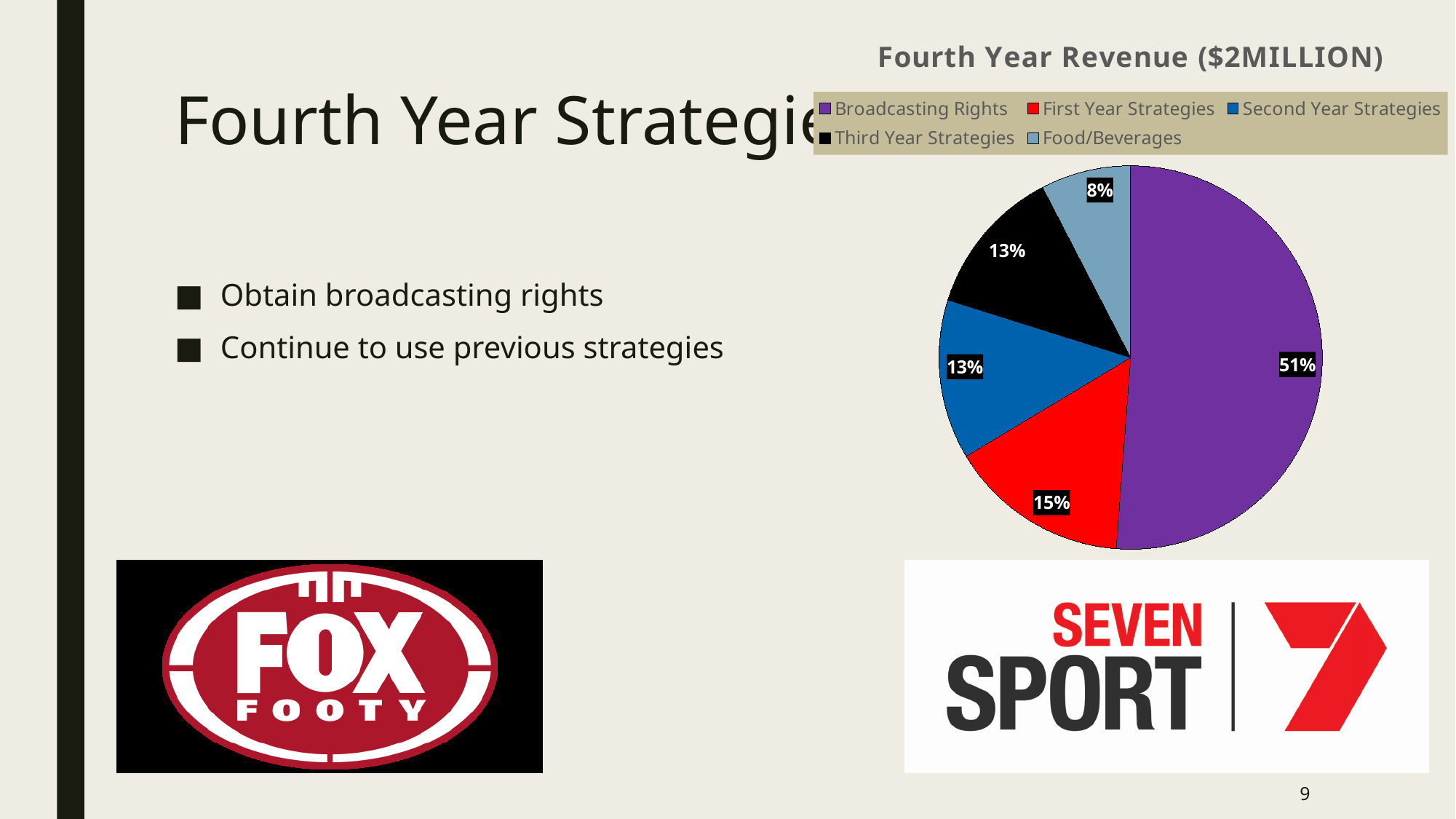
What percentage is shown for Food/Beverages? 8% Which is larger, the slice for First Year Strategies or the slice for Third Year Strategies? First Year Strategies How many categories does the legend list? 5 What share of the pie does Broadcasting Rights take? 51% What is the title of the chart? Fourth Year Revenue ($2MILLION) Which category has the largest slice of the pie? Broadcasting Rights What percentage is shown for Second Year Strategies? 13% Which category has the smallest slice of the pie? Food/Beverages What is the difference in percentage points between Broadcasting Rights and First Year Strategies? 36 What colour is the slice for Third Year Strategies? black What type of chart is shown on the slide? pie chart What percentage is shown for First Year Strategies? 15%